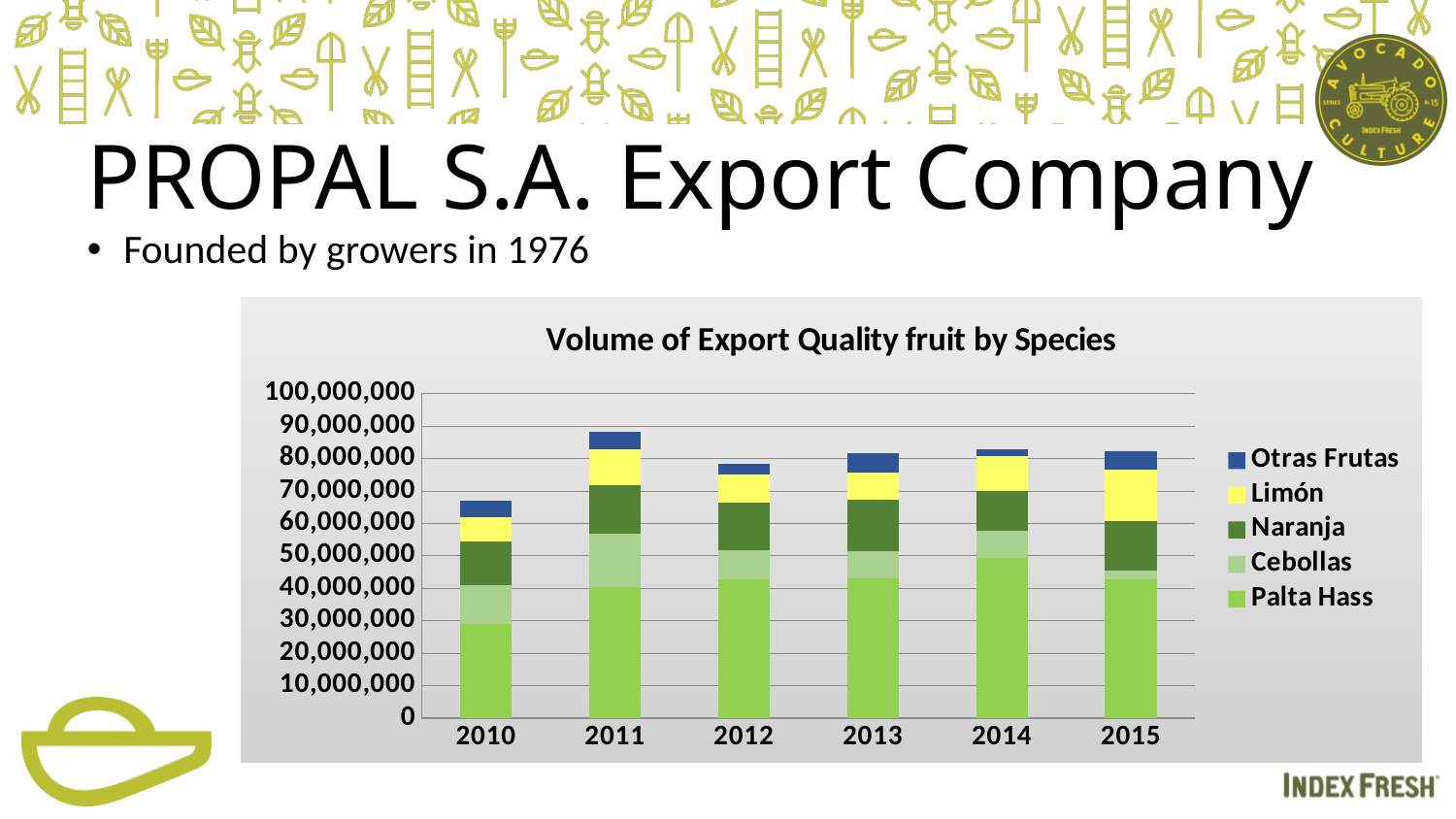
What is the title of the chart? Volume of Export Quality fruit by Species How many years are shown on the x axis of the chart? 6 Which year has the highest total stacked bar? 2011 Which year has the lowest total stacked bar? 2010 Does the Palta Hass segment rise or fall from 2010 to 2014? rise Is the Palta Hass value for 2014 greater or less than 40,000,000? greater Which year has the largest Palta Hass segment? 2014 How many series does the chart legend list? 5 Which year has a larger total stacked bar, 2011 or 2012? 2011 Is the total stacked bar for 2010 greater or less than 70,000,000? less Is the total stacked bar for 2011 greater or less than 80,000,000? greater What kind of chart is shown on the slide? Stacked bar chart